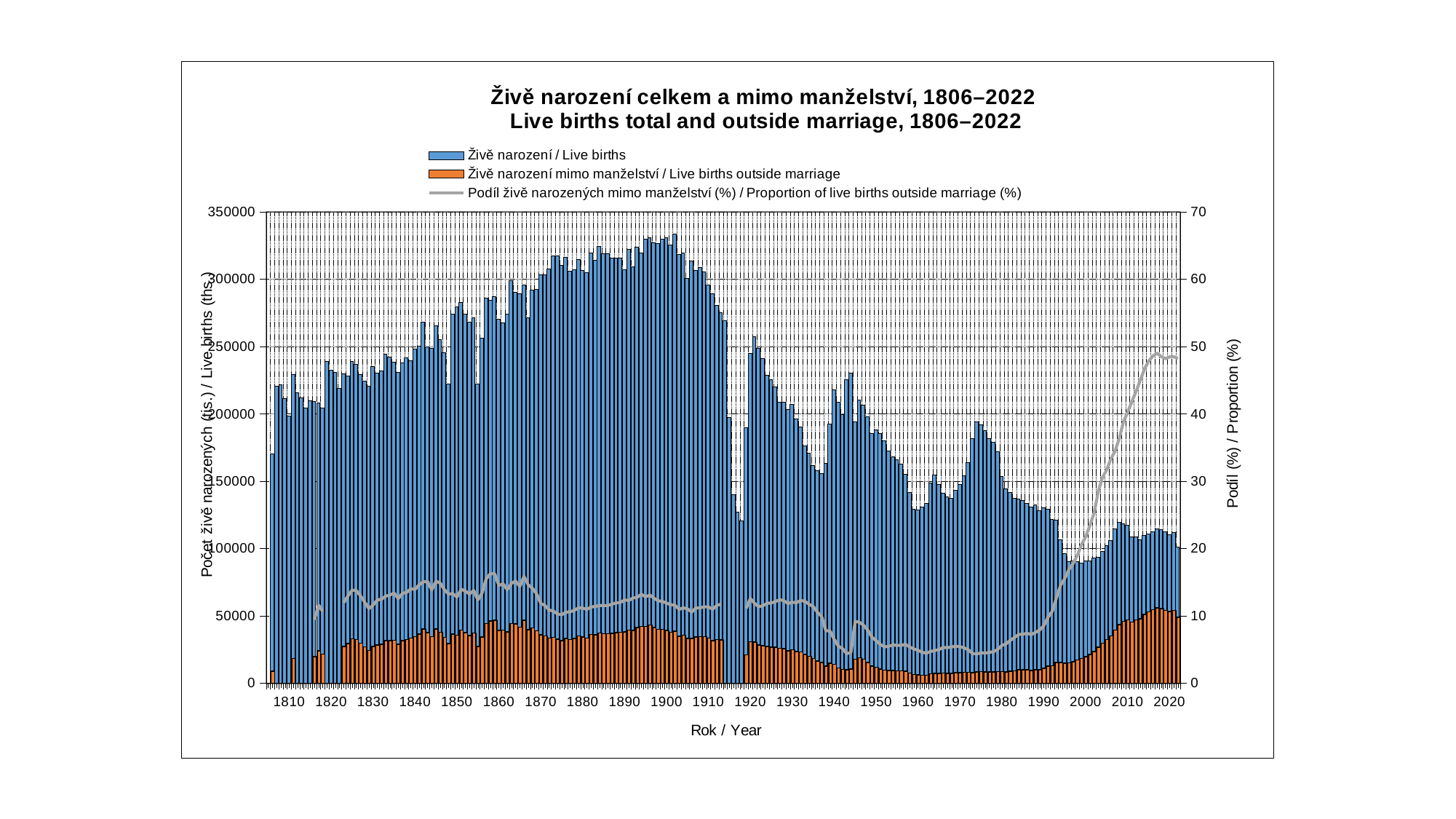
Which year has more live births in total, 1900 or 2000? 1900 Is the value for live births (Živě narození) in 1900 greater or less than 300000? greater Is the value for live births (Živě narození) in 1990 greater or less than 150000? less Is the proportion of live births outside marriage in 1960 greater or less than 10? less What is the label of the x axis? Rok / Year Which series is drawn as a grey line? Podíl živě narozených mimo manželství (%) / Proportion of live births outside marriage (%) Do total live births rise or fall between 1900 and 1920? fall Does the proportion of live births outside marriage rise or fall between 1990 and 2020? rise How many series does the legend list? 3 What kind of chart is shown on the slide? bar chart with a line